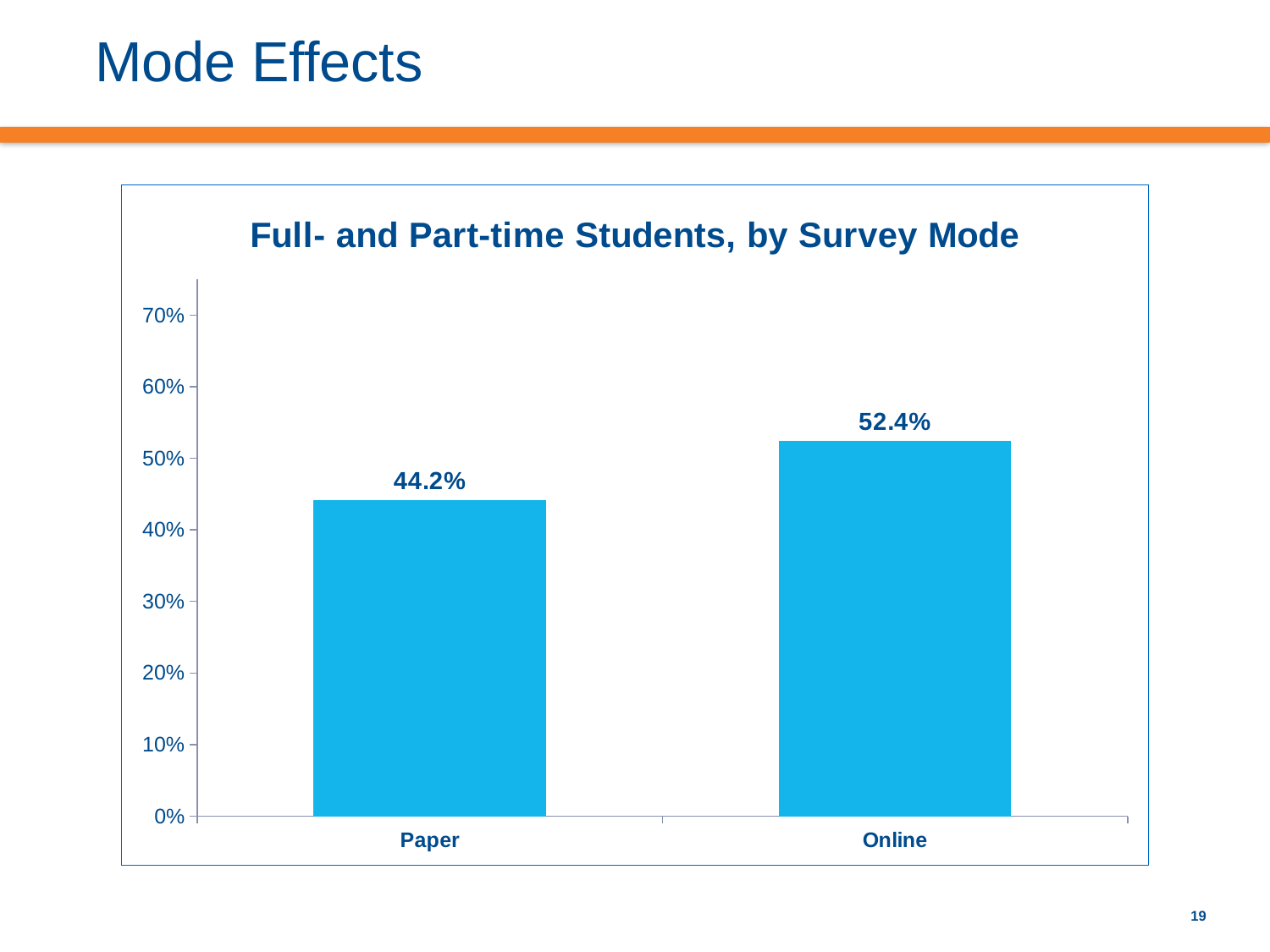
What is the value for Paper? 44.2% What is the value for Online? 52.4% Is the value for Online greater or less than 50%? greater Which survey mode has the lowest value? Paper What kind of chart is shown on the slide? bar chart What is the highest value labelled on the y axis? 70% What is the title of the chart? Full- and Part-time Students, by Survey Mode How many categories are shown on the x axis? 2 Which survey mode has the highest value? Online Which is larger, the value for Paper or the value for Online? Online Is the value for Paper greater or less than 50%? less What is the difference between the Online and Paper values? 8.2%